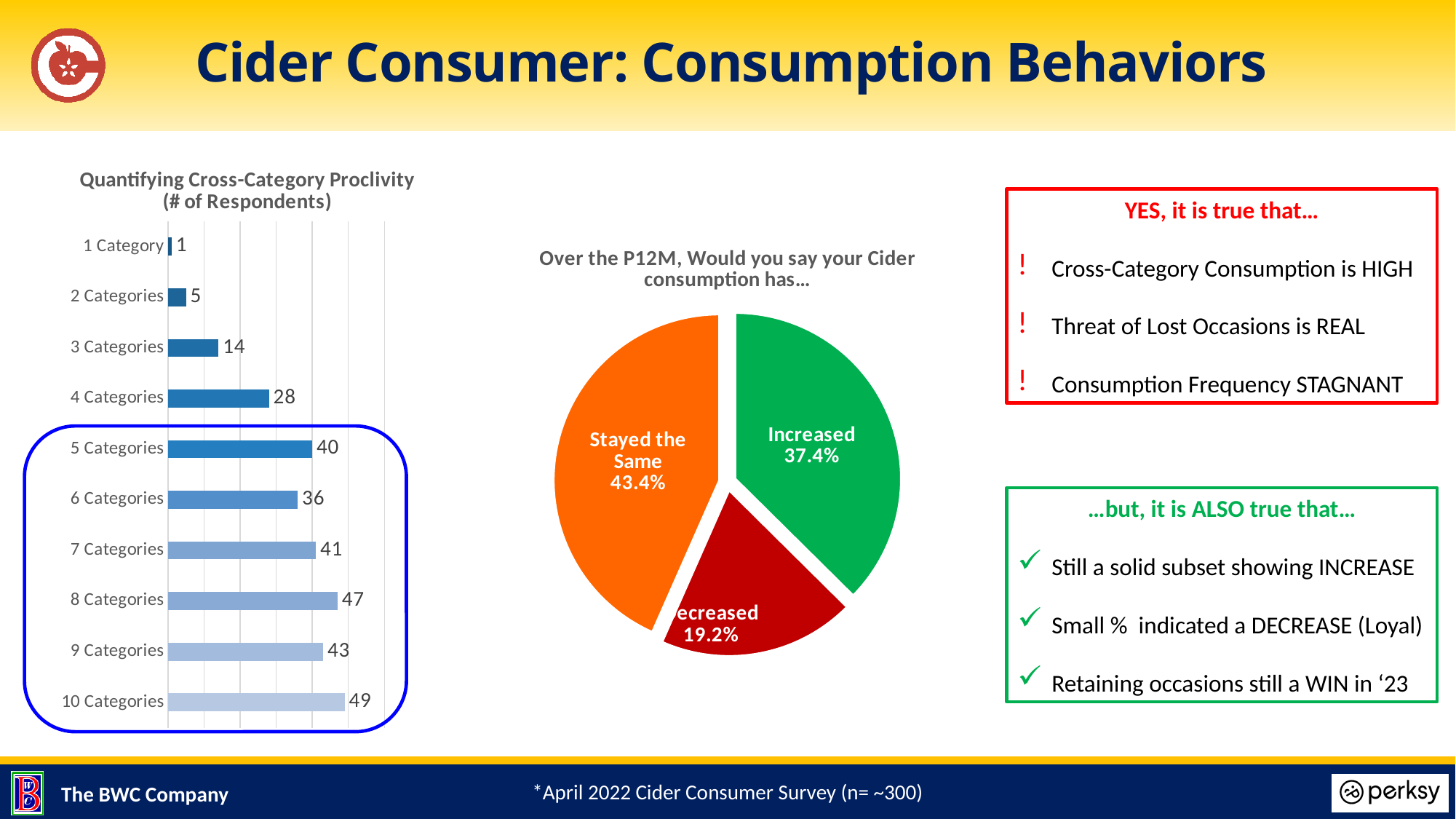
In the pie chart 'Over the P12M, Would you say your Cider consumption has…', what is the difference between the Stayed the Same share and the Decreased share? 24.2% How many slices does the pie chart 'Over the P12M, Would you say your Cider consumption has…' have? 3 In the 'Quantifying Cross-Category Proclivity' bar chart, which has more respondents, 5 Categories or 6 Categories? 5 Categories In the 'Quantifying Cross-Category Proclivity' bar chart, how many respondents are in the 4 Categories bar? 28 In the pie chart 'Over the P12M, Would you say your Cider consumption has…', what colour is the Decreased slice? Red In the pie chart 'Over the P12M, Would you say your Cider consumption has…', what share of respondents said their consumption Increased? 37.4% In the pie chart 'Over the P12M, Would you say your Cider consumption has…', which response has the largest share? Stayed the Same How many categories are shown in the 'Quantifying Cross-Category Proclivity' bar chart? 10 In the 'Quantifying Cross-Category Proclivity' bar chart, which category has the highest number of respondents? 10 Categories In the 'Quantifying Cross-Category Proclivity' bar chart, which category has the lowest number of respondents? 1 Category In the 'Quantifying Cross-Category Proclivity' bar chart, what is the difference between the values for 8 Categories and 7 Categories? 6 What kind of chart is 'Quantifying Cross-Category Proclivity'? Bar chart